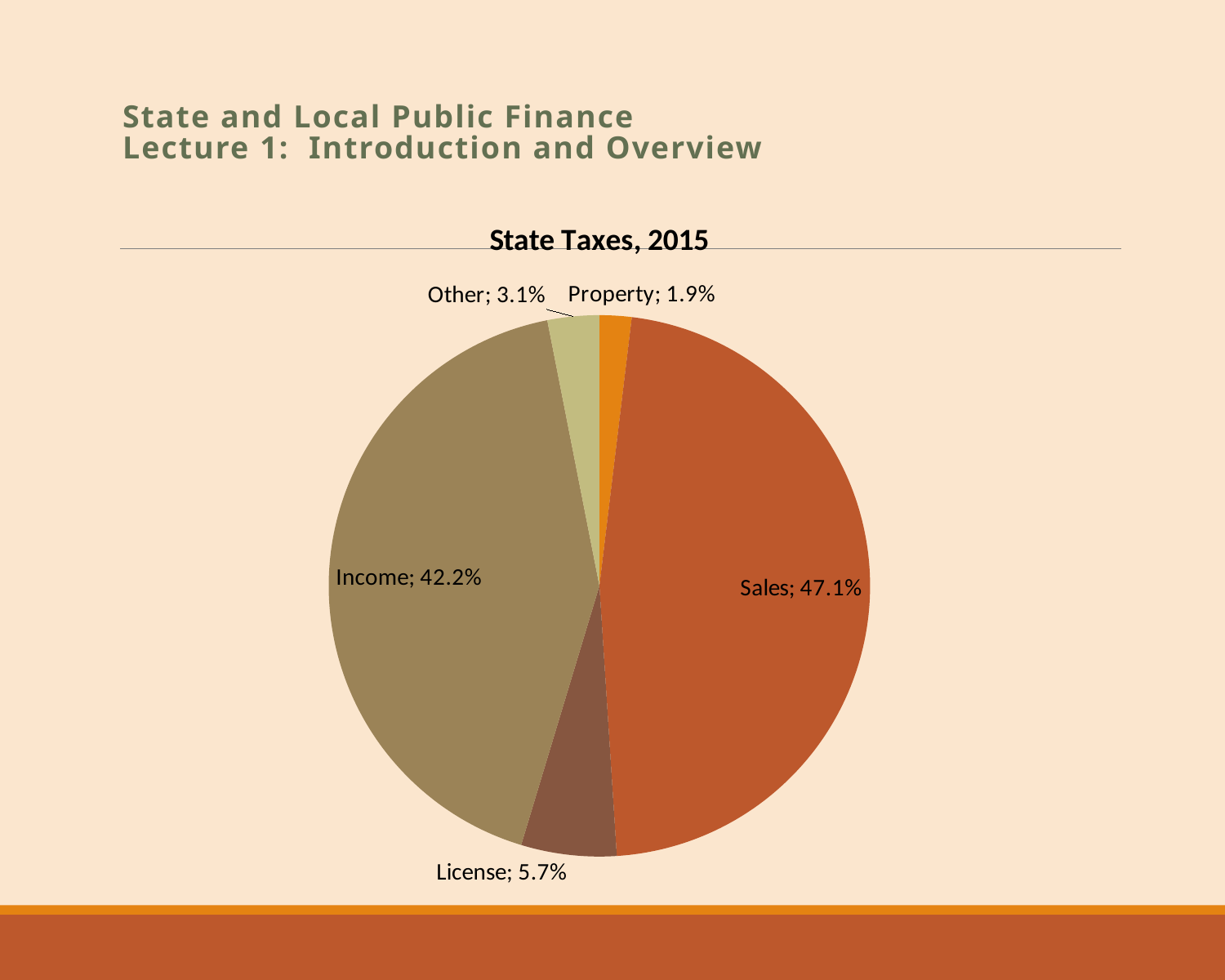
Which category has the largest slice of the pie? Sales What share of state taxes comes from Property? 1.9% What share of state taxes comes from Other? 3.1% Which is larger, the share for License or the share for Other? License What share of state taxes comes from Sales? 47.1% What share of state taxes comes from License? 5.7% What share of state taxes comes from Income? 42.2% What is the difference in percentage points between the Sales and Income shares? 4.9 Which category has the smallest slice of the pie? Property How many categories are shown in the pie chart? 5 What kind of chart is shown on the slide? pie chart What is the title of the chart? State Taxes, 2015